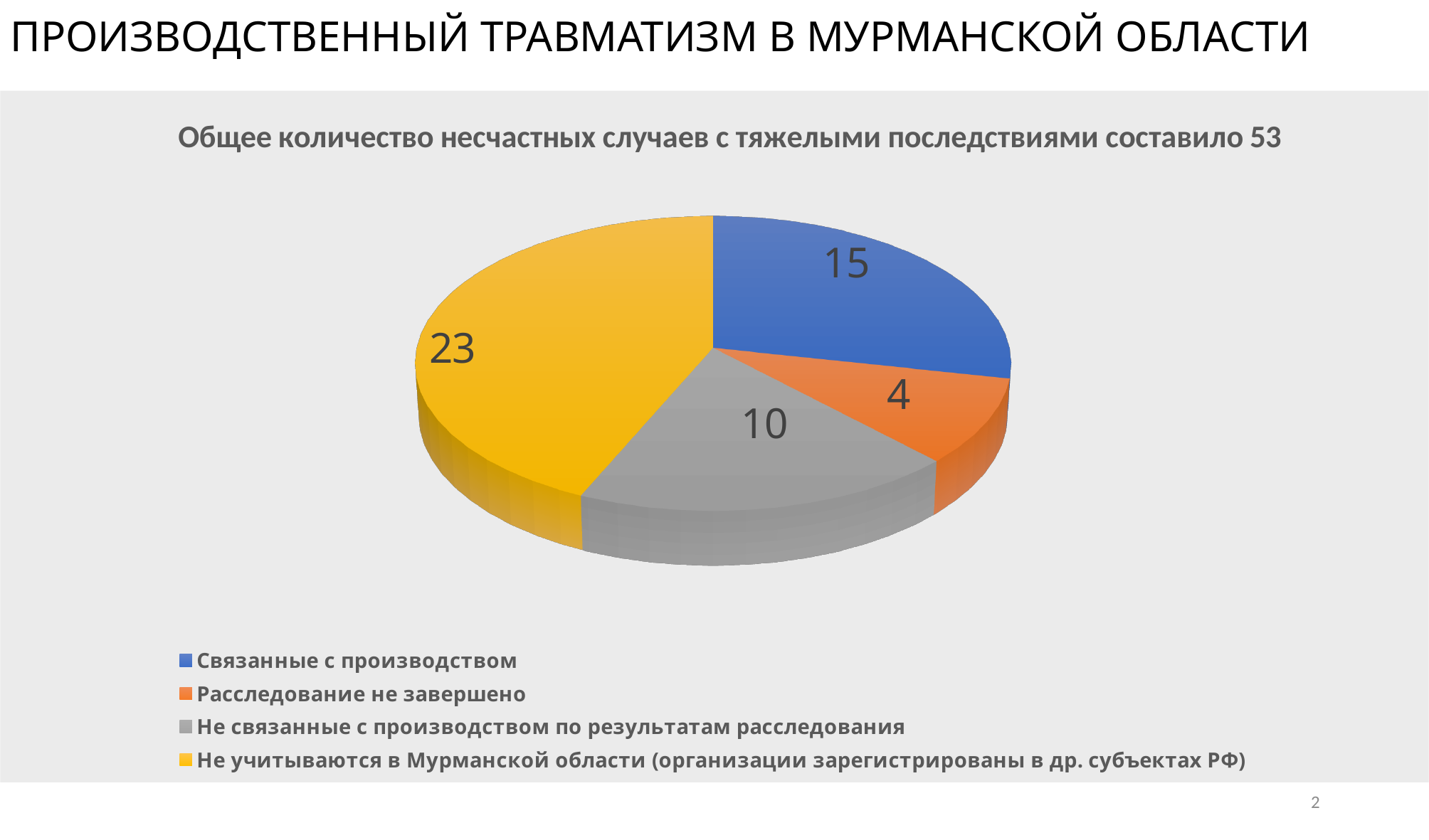
What colour is the slice for "Расследование не завершено"? Orange What is the value for "Не учитываются в Мурманской области (организации зарегистрированы в др. субъектах РФ)"? 23 What is the difference between the values for "Не учитываются в Мурманской области" and "Не связанные с производством по результатам расследования"? 13 Which is larger: the value for "Связанные с производством" or the value for "Не связанные с производством по результатам расследования"? Связанные с производством How many slices does the pie chart have? 4 Which category has the largest slice of the pie? Не учитываются в Мурманской области (организации зарегистрированы в др. субъектах РФ) What kind of chart is shown on the slide? Pie chart What is the value for "Расследование не завершено"? 4 What is the value for "Связанные с производством"? 15 What is the difference between the values for "Связанные с производством" and "Расследование не завершено"? 11 What is the value for "Не связанные с производством по результатам расследования"? 10 Which category has the smallest slice of the pie? Расследование не завершено